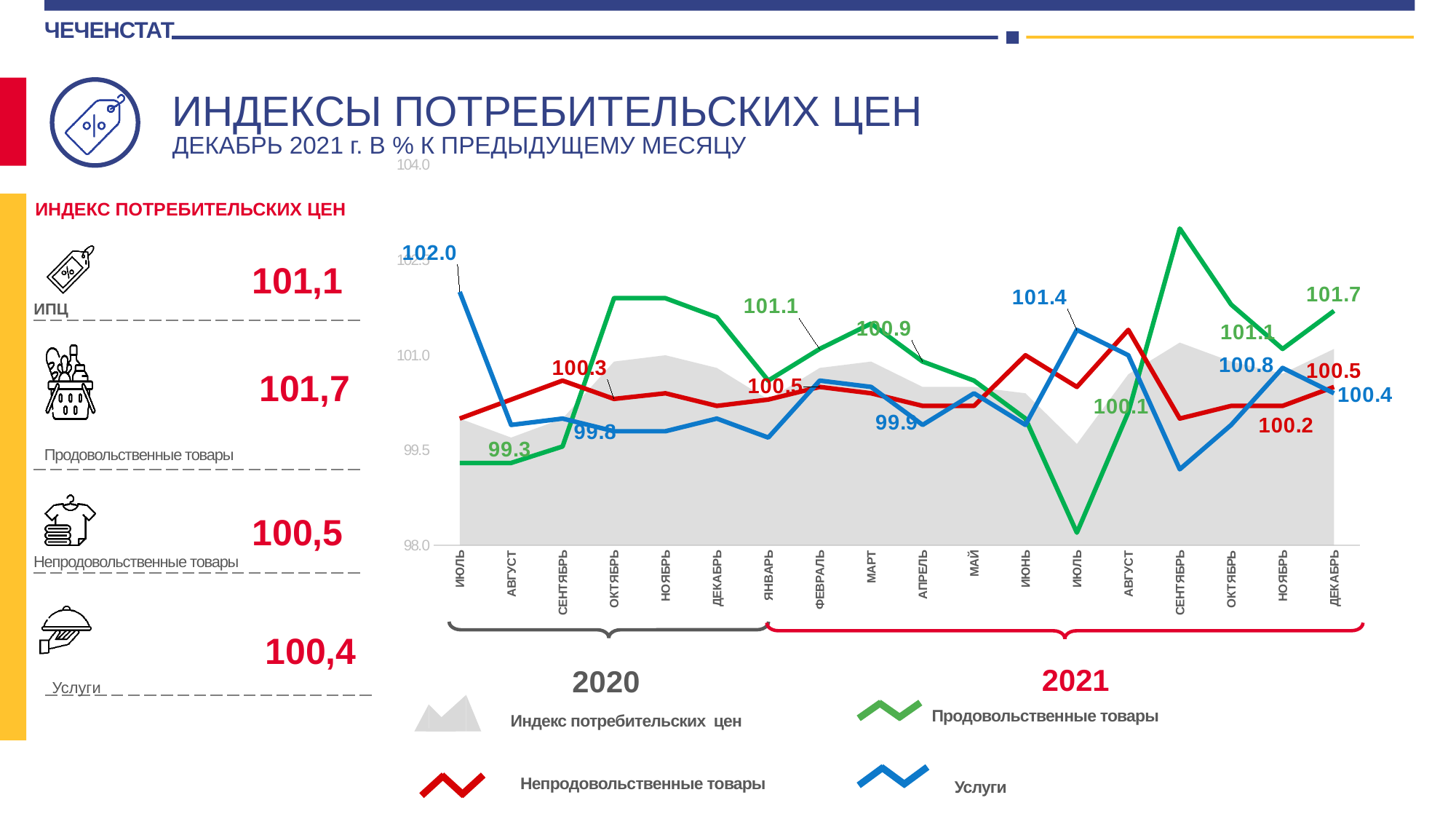
How many months are shown along the x axis of the chart? 18 What is the value for Услуги in July 2021? 101.4 What is the difference between Продовольственные товары and Услуги in December 2021? 1.3 How many series does the chart legend list? 4 Is the value for Продовольственные товары in July 2021 greater or less than 99.5? less What kind of chart is shown on the slide? combination area and line chart What is the value for Услуги in July 2020? 102.0 What is the value for Непродовольственные товары in December 2021? 100.5 What is the value for Продовольственные товары in December 2021? 101.7 Which series has the highest value in December 2021? Продовольственные товары What is the value for Продовольственные товары in August 2020? 99.3 What is the value for Услуги in December 2021? 100.4